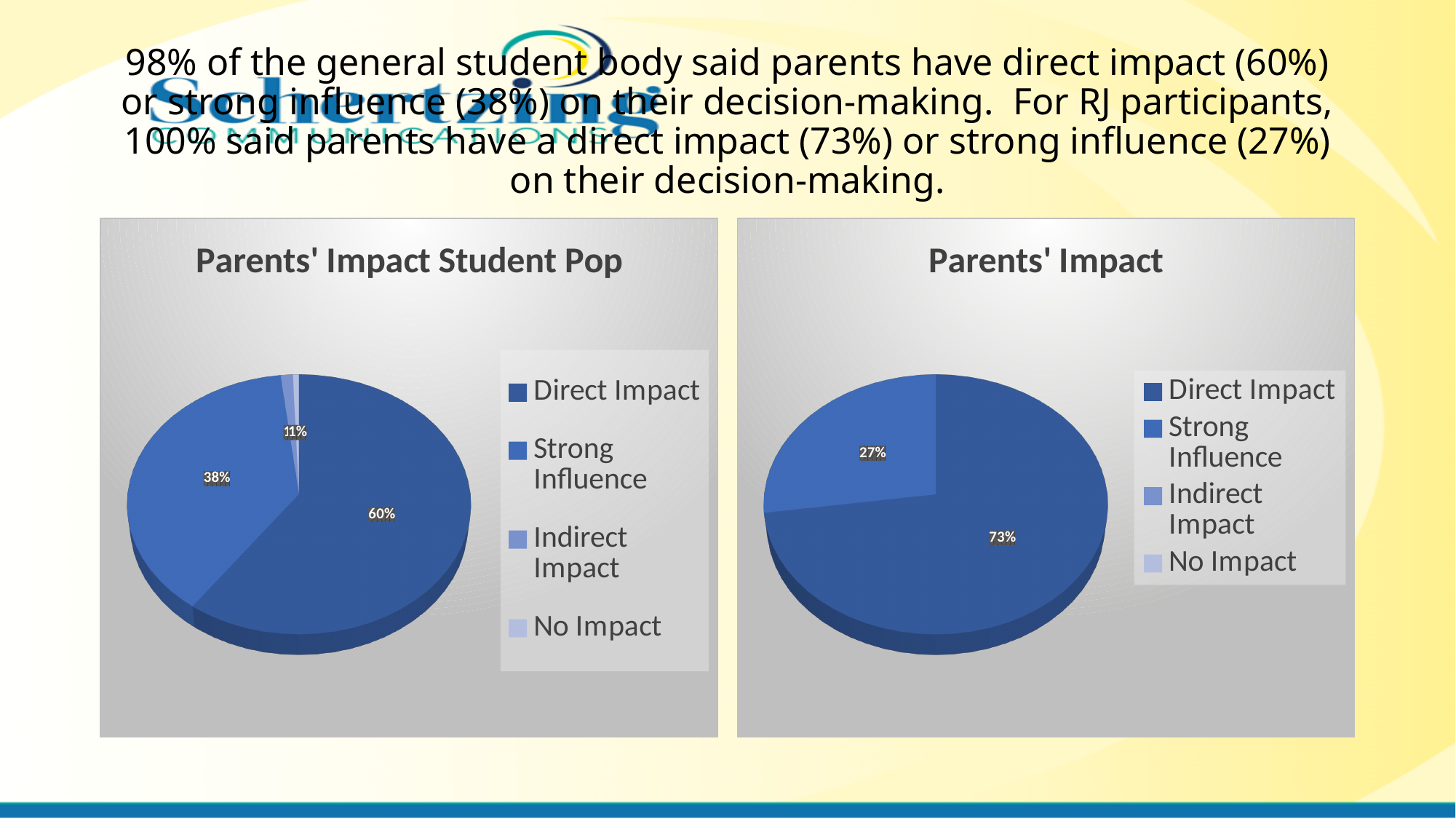
Which chart shows a larger share for Direct Impact, 'Parents' Impact Student Pop' or 'Parents' Impact'? Parents' Impact In the 'Parents' Impact Student Pop' chart, how many percentage points larger is Direct Impact than Strong Influence? 22 percentage points In the 'Parents' Impact Student Pop' chart, what percentage is shown for Strong Influence? 38% How many entries does the legend of the 'Parents' Impact Student Pop' chart list? 4 In the 'Parents' Impact' chart on the right, what percentage is shown for Direct Impact? 73% In the 'Parents' Impact Student Pop' chart, what percentage is shown for Direct Impact? 60% What kind of chart is the 'Parents' Impact Student Pop' chart on the left? Pie chart In the 'Parents' Impact' chart on the right, how many percentage points larger is Direct Impact than Strong Influence? 46 percentage points What is the title of the chart on the right side of the slide? Parents' Impact In the 'Parents' Impact' chart on the right, what percentage is shown for Strong Influence? 27% In the 'Parents' Impact' chart on the right, which category has the largest slice? Direct Impact In the 'Parents' Impact Student Pop' chart, which category has the largest slice? Direct Impact